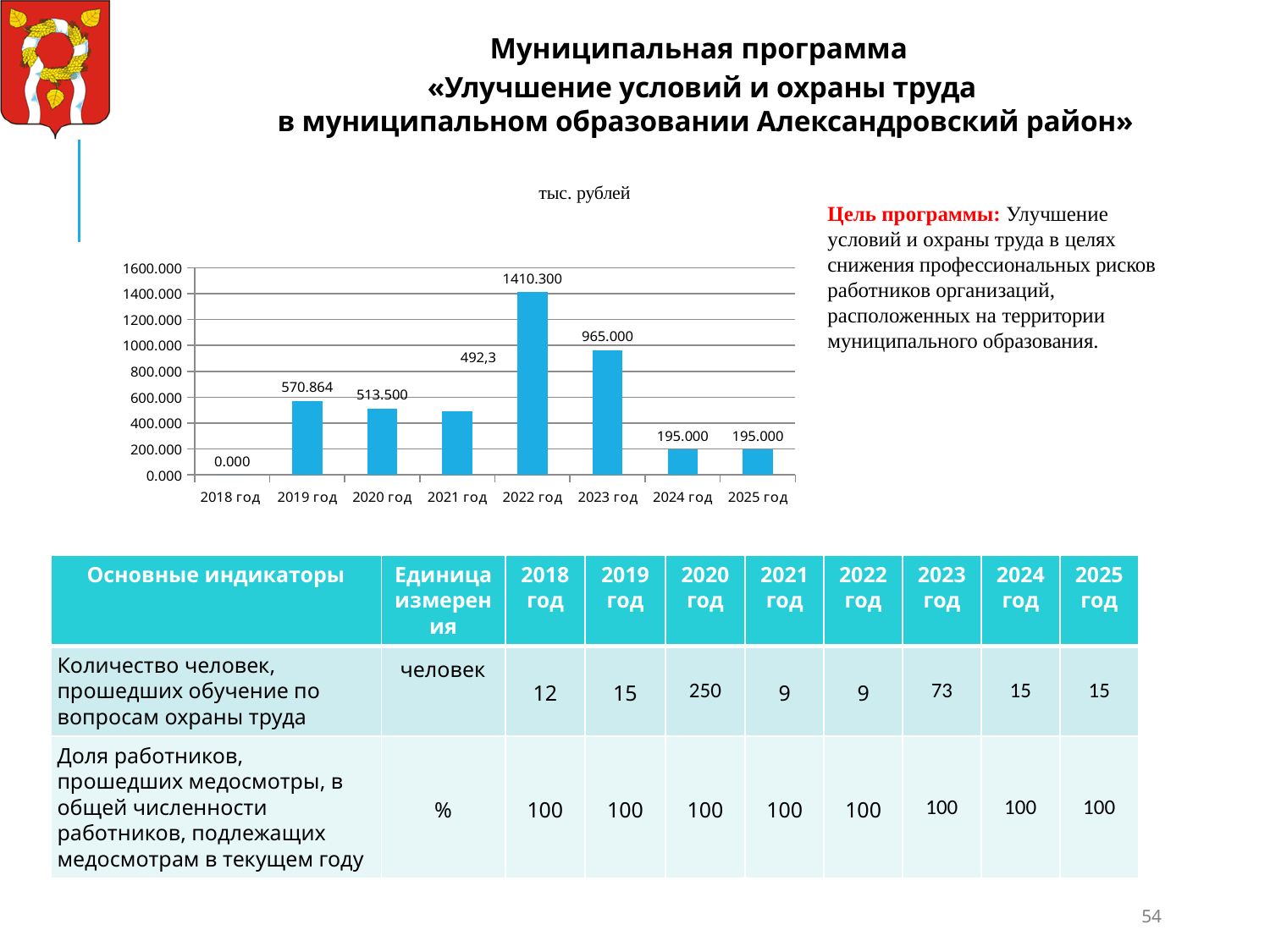
Which is larger, the value for 2019 год or 2020 год? 2019 год What kind of chart is shown? bar chart What is the value for 2021 год? 492,3 What is the value for 2019 год? 570.864 What is the value for 2024 год? 195.000 Do the values rise or fall from 2019 год to 2021 год? fall Is the value for 2023 год greater or less than 800.000? greater Which year has the lowest value? 2018 год What is the difference between the values for 2022 год and 2023 год? 445.300 What is the value for 2022 год? 1410.300 Which year has the highest value? 2022 год How many years are shown on the x axis? 8